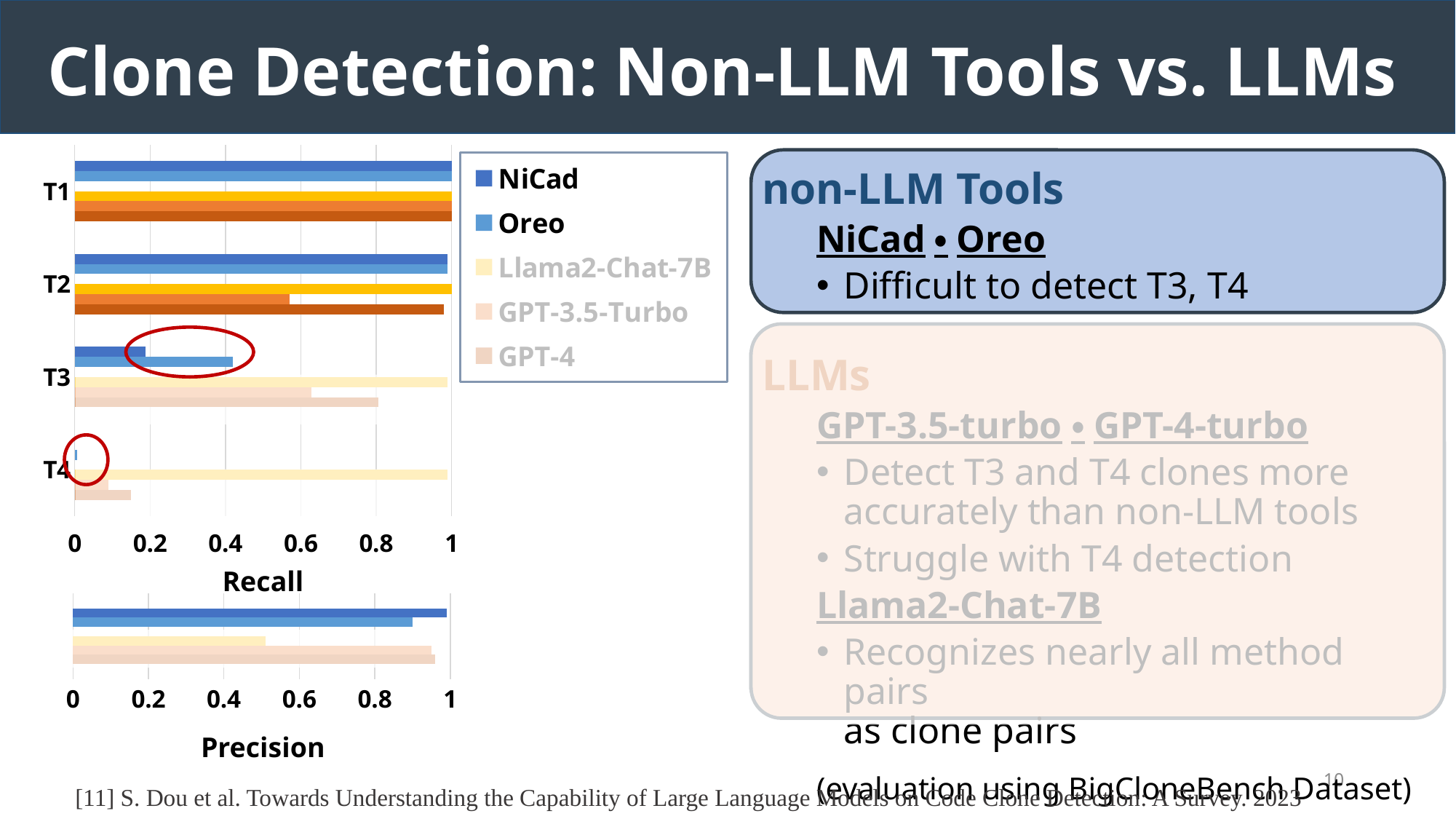
In the Recall chart, which has the larger recall at T3, NiCad or Oreo? Oreo In the Recall chart, which series has the highest recall at T3? Llama2-Chat-7B In the Precision chart, which series has the lowest precision? Llama2-Chat-7B How many clone-type categories (T1, T2, ...) are shown on the Recall chart? 4 In the Recall chart, is the value for NiCad at T3 greater or less than 0.4? less In the Recall chart, is the value for GPT-4 at T4 greater or less than 0.4? less In the Recall chart, is the value for GPT-3.5-Turbo at T2 greater or less than 0.8? less What kind of chart is the Recall chart on the left of the slide? bar chart In the Recall chart, does the recall for NiCad rise or fall from T1 to T4? fall How many series does the legend of the Recall chart list? 5